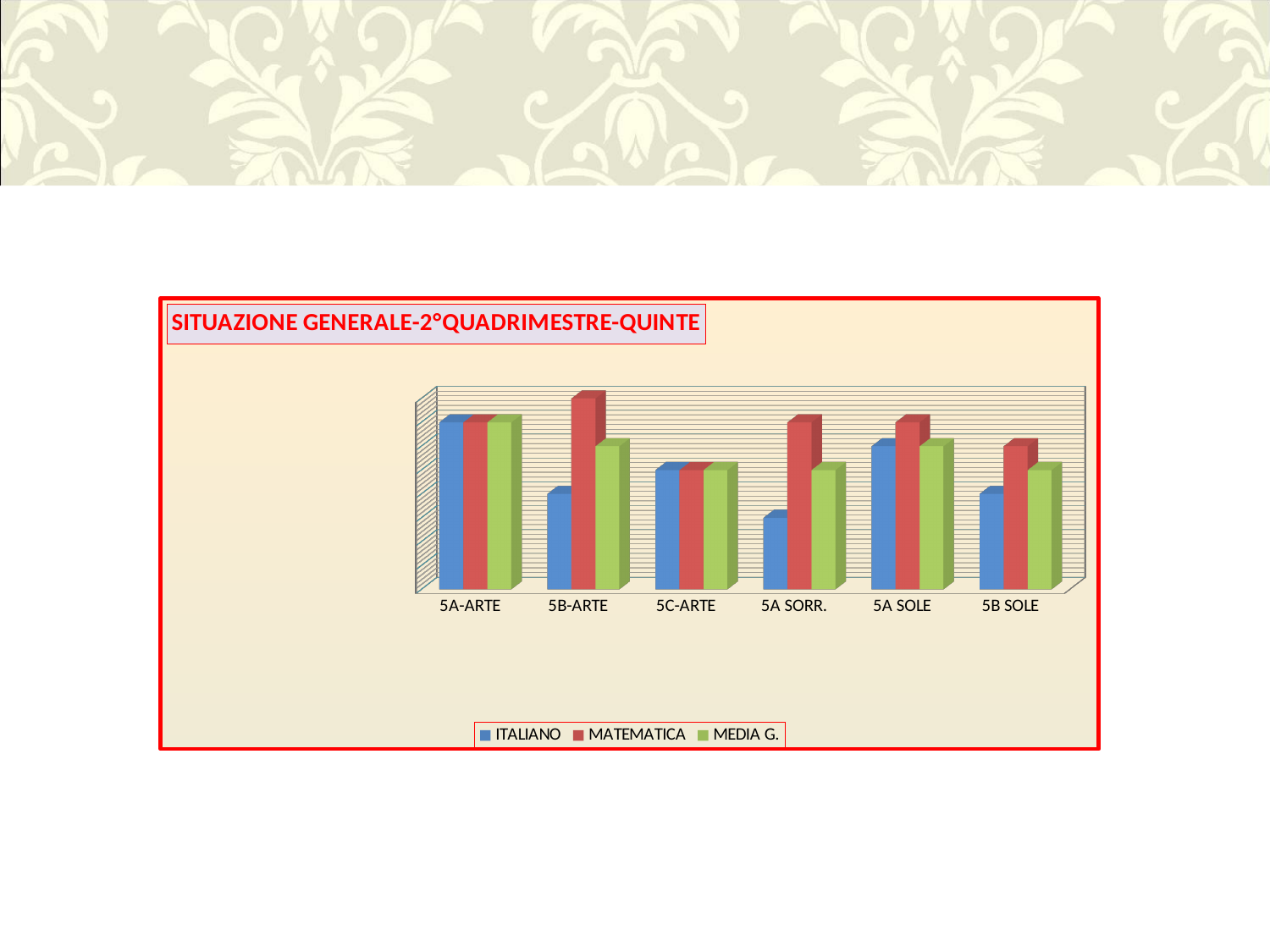
How many series does the legend list? 3 For which category is the MATEMATICA bar the highest? 5B-ARTE What kind of chart is shown on the slide? bar chart For 5B-ARTE, which is larger: the ITALIANO bar or the MATEMATICA bar? MATEMATICA How many categories are shown on the x axis? 6 Which category has the larger ITALIANO bar: 5A SOLE or 5B SOLE? 5A SOLE What is the title of the chart? SITUAZIONE GENERALE-2°QUADRIMESTRE-QUINTE Which series is shown in red in the legend? MATEMATICA For which category is the MEDIA G. bar the highest? 5A-ARTE For which category is the ITALIANO bar the lowest? 5A SORR. For which category is the ITALIANO bar the highest? 5A-ARTE For which category is the MATEMATICA bar the lowest? 5C-ARTE